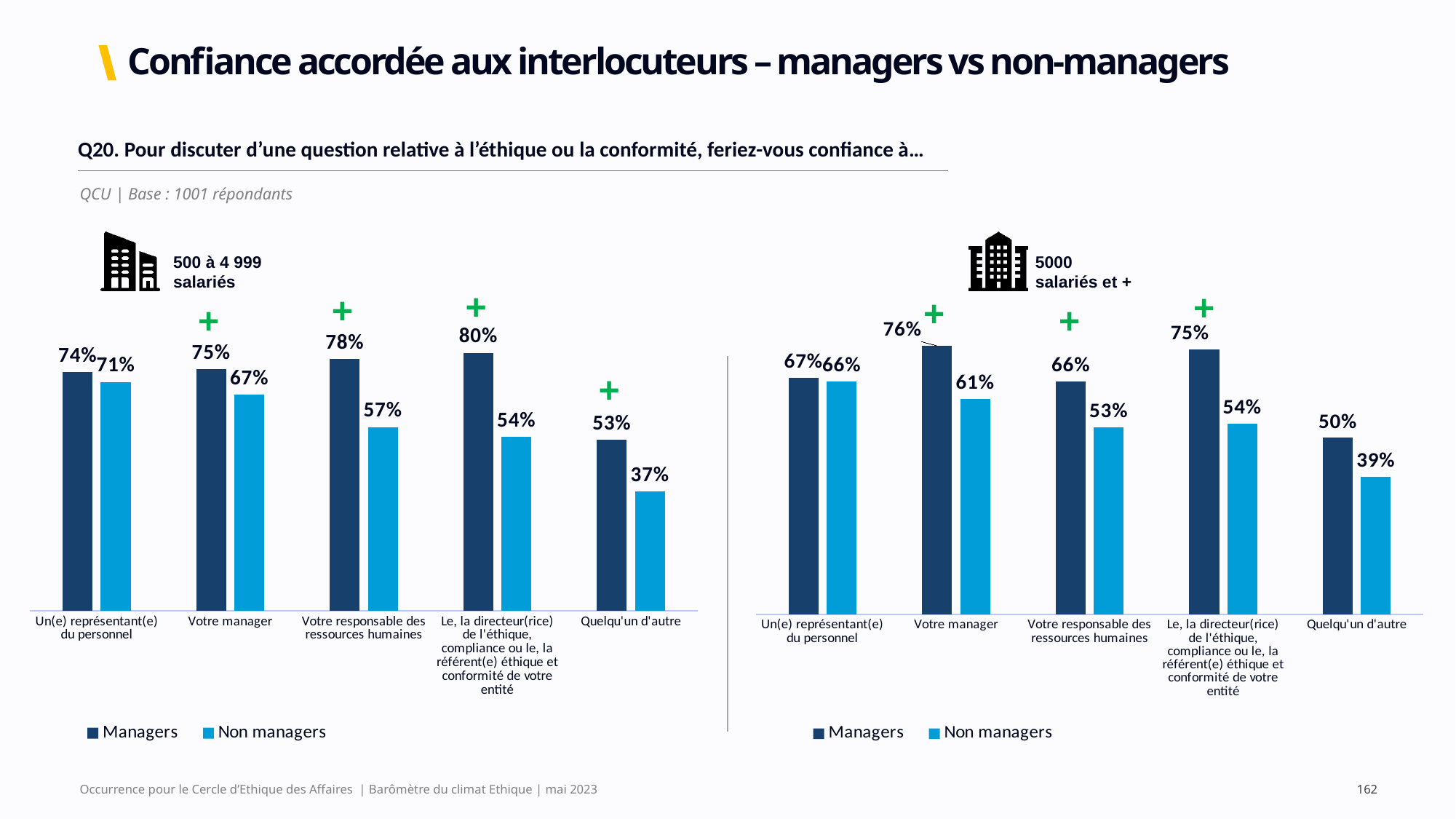
In the left chart (500 à 4 999 salariés), what is the Non managers value for "Quelqu'un d'autre"? 37% In the right chart (5000 salariés et +), what is the difference between the Managers and Non managers values for "Le, la directeur(rice) de l'éthique..."? 21 percentage points In the right chart (5000 salariés et +), what is the Managers value for "Votre responsable des ressources humaines"? 66% What type of chart is used on the left (500 à 4 999 salariés)? Bar chart In the right chart (5000 salariés et +), what is the Non managers value for "Votre manager"? 61% In the right chart (5000 salariés et +), which category has the lowest Non managers value? Quelqu'un d'autre In the left chart (500 à 4 999 salariés), which category has the highest Managers value? Le, la directeur(rice) de l'éthique, compliance ou le, la référent(e) éthique et conformité de votre entité In the left chart (500 à 4 999 salariés), what is the Managers value for "Votre manager"? 75% In the left chart (500 à 4 999 salariés), what is the difference between the Managers and Non managers values for "Votre responsable des ressources humaines"? 21 percentage points How many categories are shown on the x axis of the left chart (500 à 4 999 salariés)? 5 How many series does the legend of the right chart (5000 salariés et +) list? 2 In the right chart (5000 salariés et +), which is larger for "Un(e) représentant(e) du personnel": the Managers value or the Non managers value? Managers